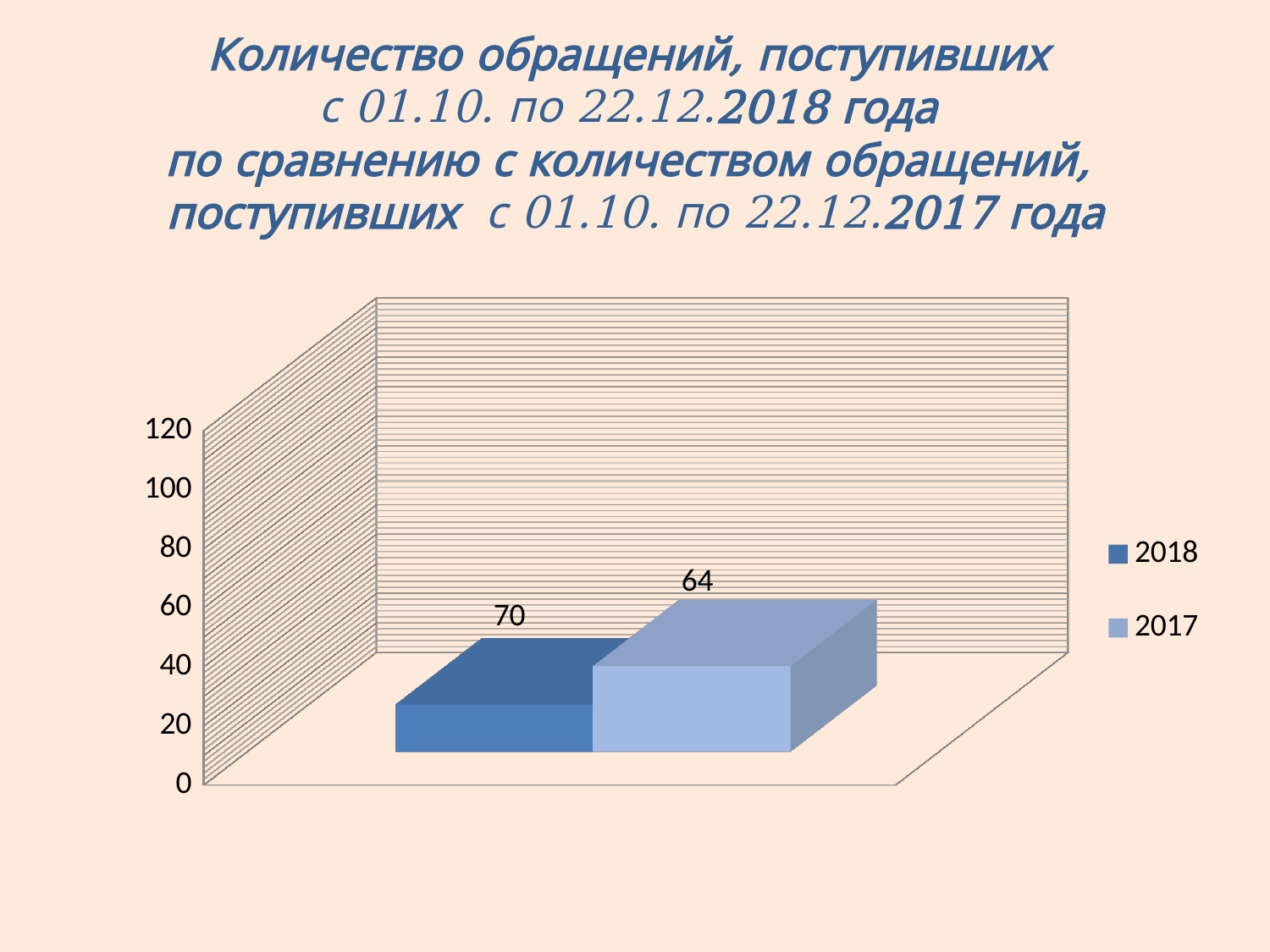
What is the value for 2018? 70 What is the highest value shown on the vertical axis? 120 Which series has the lowest value? 2017 Is the value for 2017 greater or less than 60? greater Which series has the higher value, 2018 or 2017? 2018 What is the value for 2017? 64 What is the difference between the values for 2018 and 2017? 6 What kind of chart is shown on the slide? bar chart How many series does the legend list? 2 Is the value for 2018 greater or less than 80? less Which series is shown in the lighter blue colour? 2017